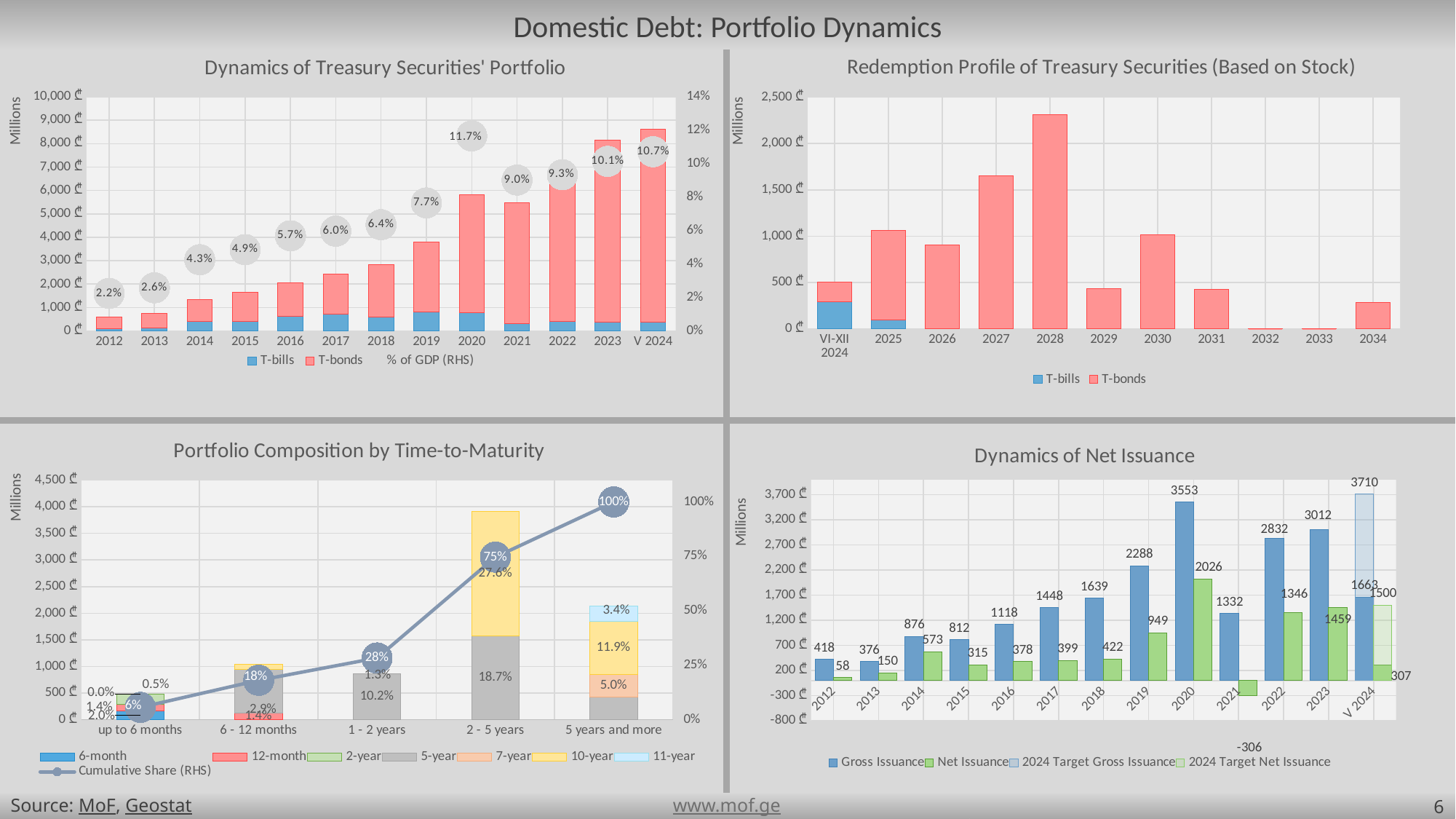
In the 'Dynamics of Net Issuance' chart, what is the Gross Issuance value for 2020? 3553 In the 'Dynamics of Treasury Securities' Portfolio' chart, what is the % of GDP value shown for 2020? 11.7% In the 'Portfolio Composition by Time-to-Maturity' chart, what is the Cumulative Share value for the '2 - 5 years' category? 75% How many categories are shown on the x axis of the 'Redemption Profile of Treasury Securities (Based on Stock)' chart? 11 In the 'Dynamics of Treasury Securities' Portfolio' chart, which year has the highest % of GDP label? 2020 In the 'Redemption Profile of Treasury Securities (Based on Stock)' chart, is the value for 2027 greater or less than 1,500? greater In the 'Dynamics of Net Issuance' chart, what is the difference between the 2024 Target Gross Issuance and the Gross Issuance for V 2024? 2047 In the 'Dynamics of Treasury Securities' Portfolio' chart, what is the difference between the % of GDP labels for V 2024 and 2023? 0.6% In the 'Portfolio Composition by Time-to-Maturity' chart, what is the 10-year share labelled in the '5 years and more' bar? 11.9% In the 'Dynamics of Net Issuance' chart, which year has the lowest Net Issuance value? 2021 How many entries does the legend of the 'Portfolio Composition by Time-to-Maturity' chart list? 8 In the 'Redemption Profile of Treasury Securities (Based on Stock)' chart, which year has the tallest bar? 2028